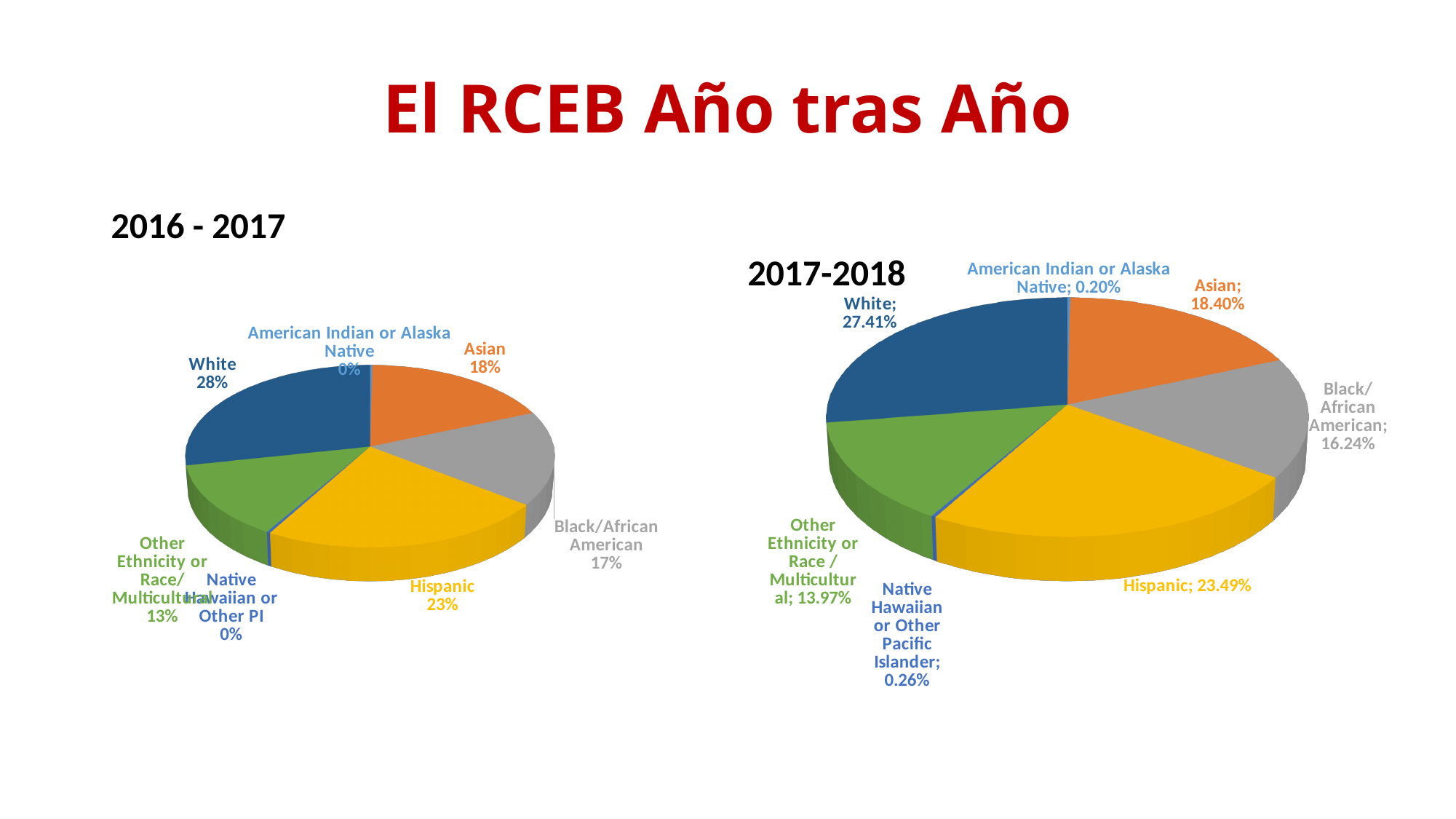
In the 2016 - 2017 pie chart, what is the difference between the Hispanic and Black/African American percentages? 6% How many categories are shown in the 2017-2018 pie chart? 7 In the 2017-2018 pie chart, what percentage is shown for Asian? 18.40% In the 2016 - 2017 pie chart, what percentage is shown for White? 28% In the 2016 - 2017 pie chart, what percentage is shown for Hispanic? 23% In the 2016 - 2017 pie chart, which category has the largest share? White In the 2017-2018 pie chart, what percentage is shown for Other Ethnicity or Race / Multicultural? 13.97% What kind of chart is used for the 2016 - 2017 data? Pie chart In the 2017-2018 pie chart, which category has the smallest share? American Indian or Alaska Native What is the title of the slide containing the two pie charts? El RCEB Año tras Año In the 2017-2018 pie chart, which category has the largest share? White In the 2017-2018 pie chart, which is larger, the share for Asian or the share for Black/African American? Asian